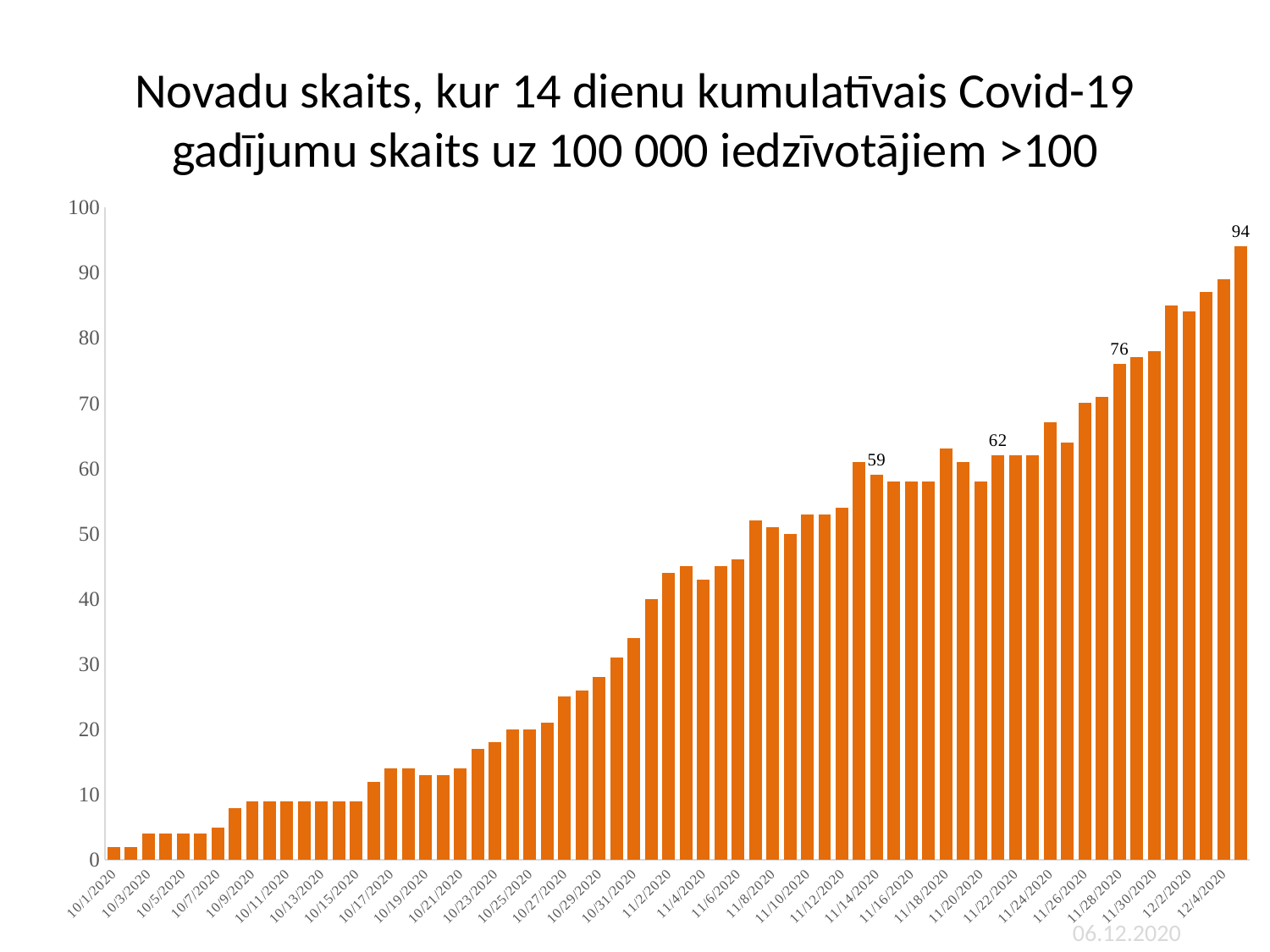
Is the value for 12/2/2020 greater or less than 80? greater Is the value for 10/1/2020 greater or less than 10? less Is the value for 11/24/2020 greater or less than 60? greater What is the difference between the bar labelled 62 and the bar labelled 59? 3 Overall, do the values rise or fall from left to right along the x axis? rise What kind of chart is shown on the slide? bar chart What colour are the bars in the chart? orange What is the value of the highest bar in the chart? 94 Which is larger: the bar labelled 76 or the bar labelled 94? 94 What is the value shown by the data label on the last (rightmost) bar? 94 What is the difference between the bar labelled 94 and the bar labelled 76? 18